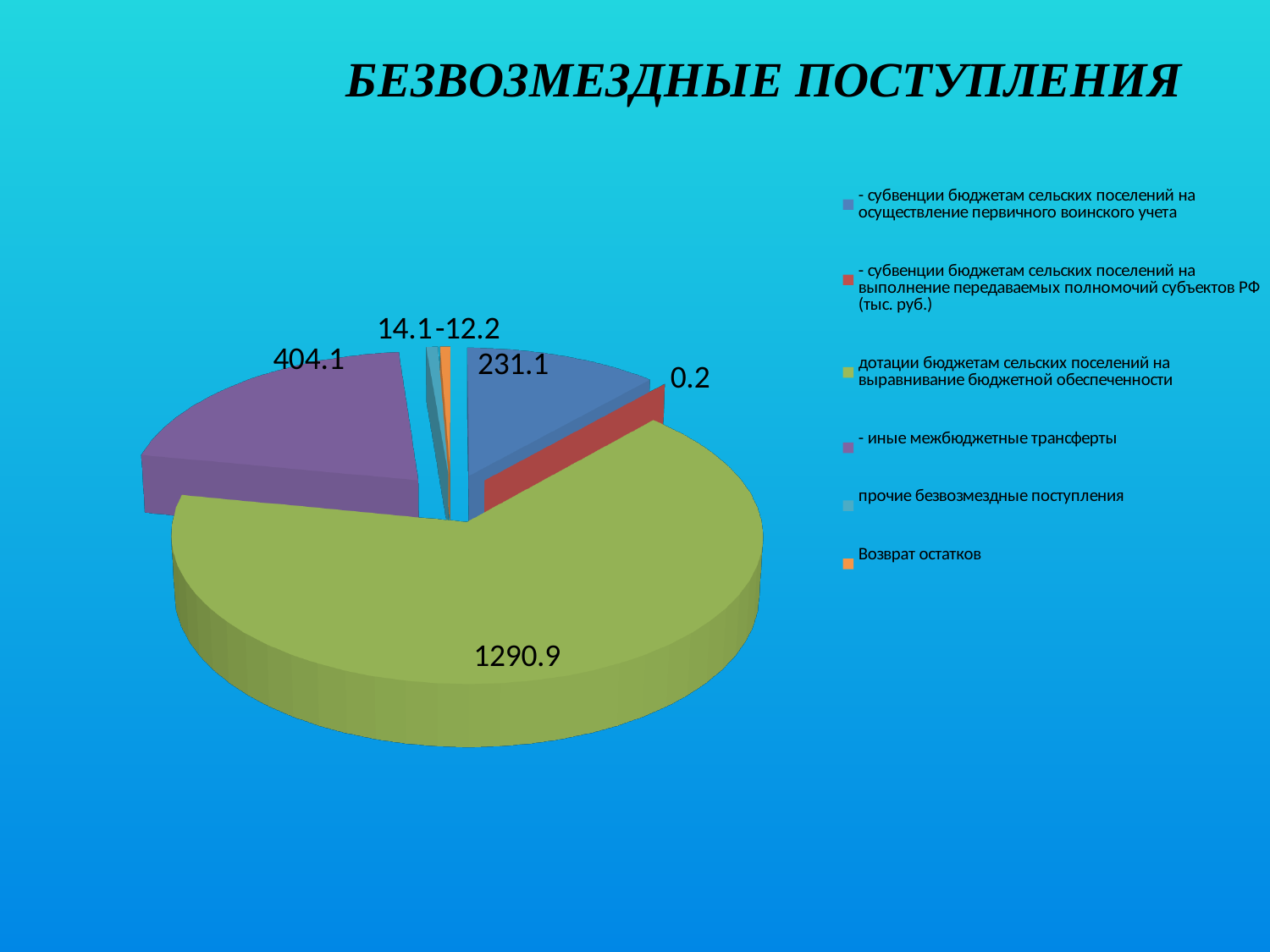
What is the value for 'дотации бюджетам сельских поселений на выравнивание бюджетной обеспеченности'? 1290.9 What kind of chart is shown on the slide? pie chart What is the value for '- иные межбюджетные трансферты'? 404.1 What is the difference between the value for 'дотации бюджетам сельских поселений на выравнивание бюджетной обеспеченности' and the value for '- иные межбюджетные трансферты'? 886.8 What is the title of the chart on the slide? БЕЗВОЗМЕЗДНЫЕ ПОСТУПЛЕНИЯ Which is larger: the value for '- иные межбюджетные трансферты' or the value for '- субвенции бюджетам сельских поселений на осуществление первичного воинского учета'? - иные межбюджетные трансферты What is the value for 'Возврат остатков'? -12.2 Which category has the largest slice of the pie? дотации бюджетам сельских поселений на выравнивание бюджетной обеспеченности Which category has the lowest value shown on the chart? Возврат остатков How many entries does the legend list? 6 What is the value for '- субвенции бюджетам сельских поселений на осуществление первичного воинского учета'? 231.1 What is the value for 'прочие безвозмездные поступления'? 14.1